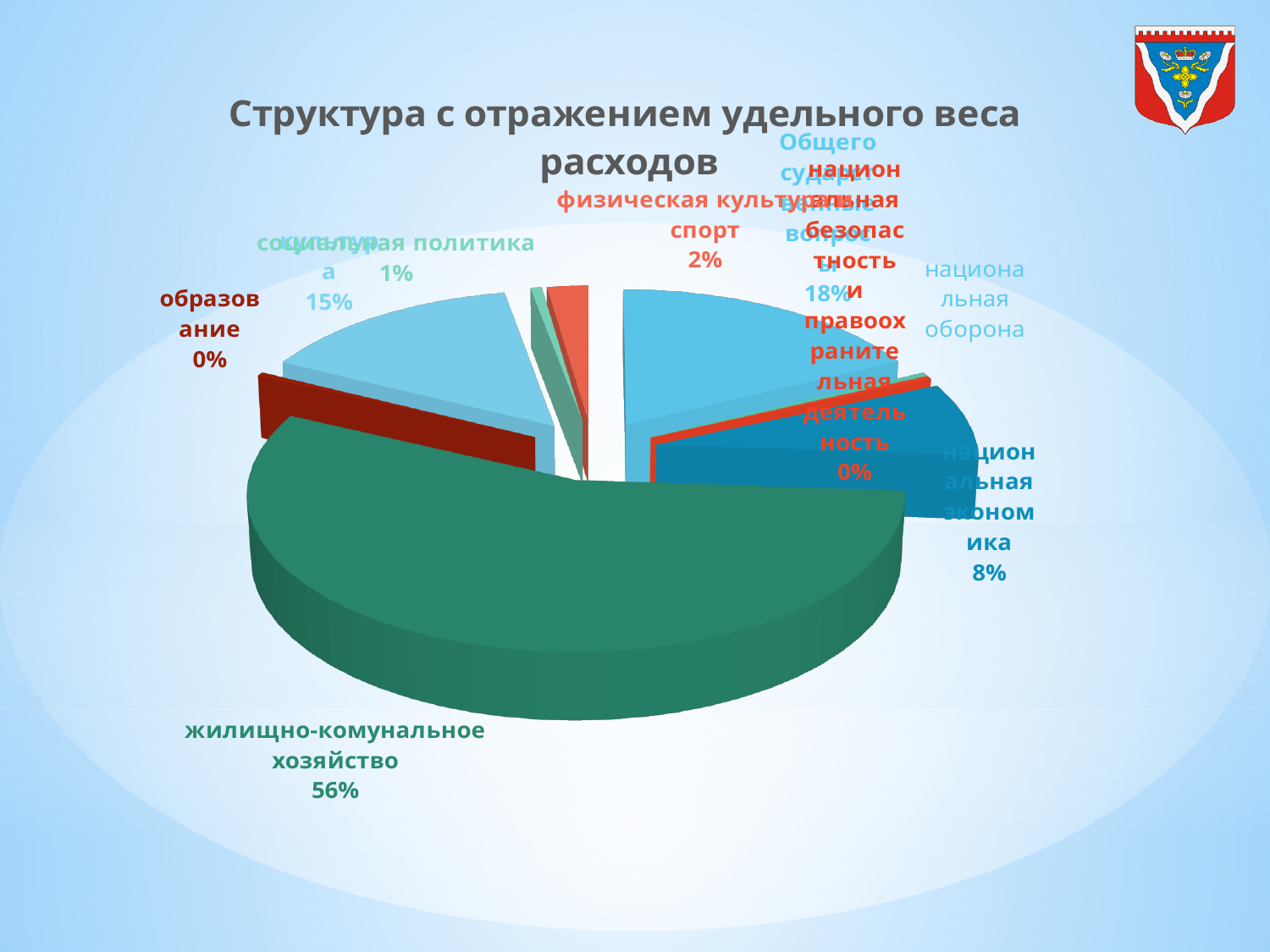
What share of expenses is shown for жилищно-коммунальное хозяйство? 56% What is the difference between the share for жилищно-коммунальное хозяйство and the share for национальная экономика? 48% What is the difference between the share for Общегосударственные вопросы and the share for национальная экономика? 10% What share of expenses is shown for физическая культура и спорт? 2% What share of expenses is shown for национальная экономика? 8% What kind of chart is shown on the slide? pie chart What share of expenses is shown for образование? 0% What is the title of the chart? Структура с отражением удельного веса расходов Which is larger: the share for жилищно-коммунальное хозяйство or the share for национальная экономика? жилищно-коммунальное хозяйство Which is larger: the share for физическая культура и спорт or the share for образование? физическая культура и спорт What share of expenses is shown for Общегосударственные вопросы? 18% Which category has the largest share of the pie? жилищно-коммунальное хозяйство